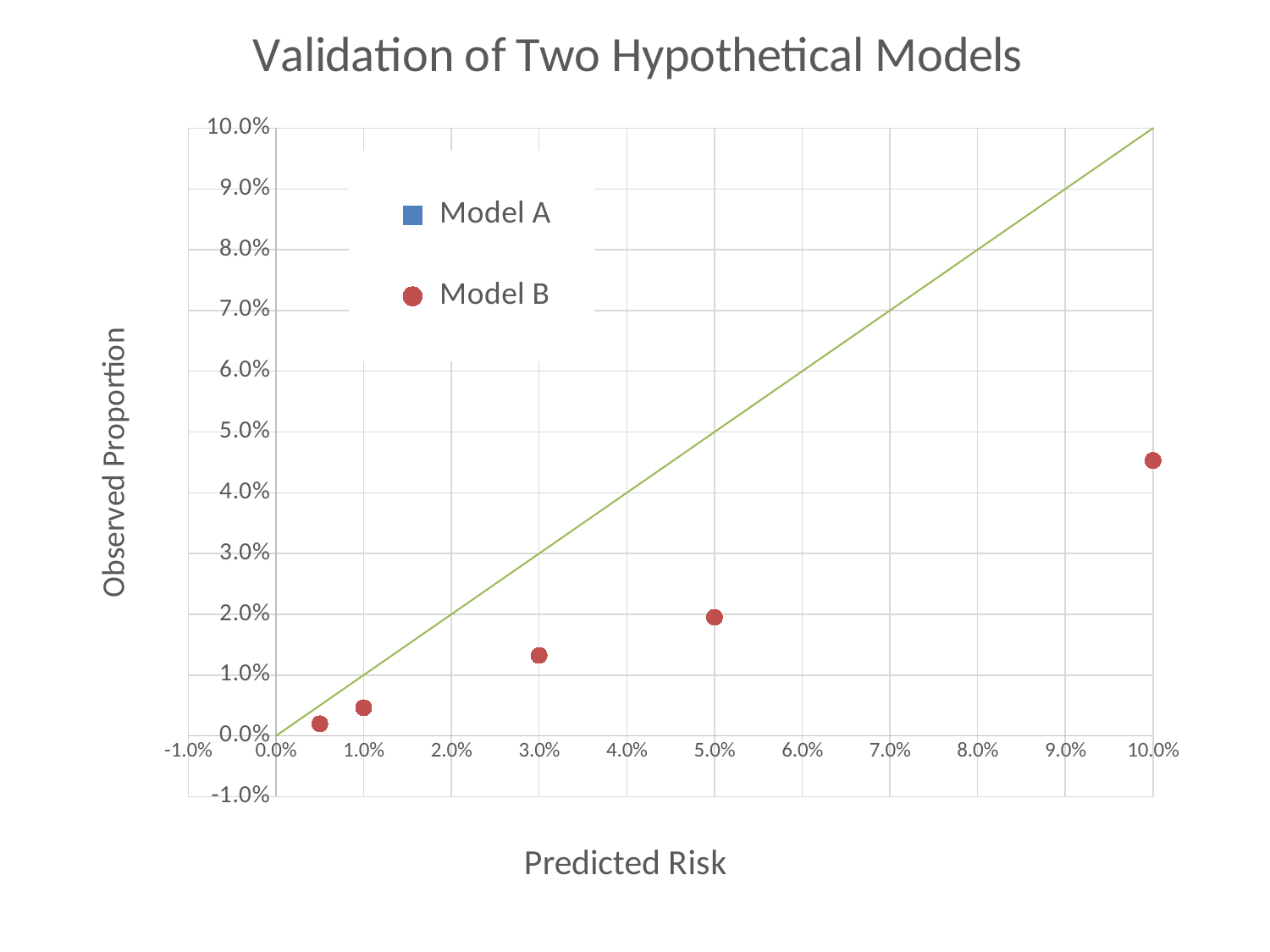
How many series does the legend list? 2 What is the label of the x axis? Predicted Risk Do the Model B observed proportions rise or fall as predicted risk increases along the x axis? rise How many Model B points are plotted on the chart? 5 What kind of chart is shown on the slide? scatter chart Is the observed proportion for Model B at a predicted risk of 10.0% greater or less than 4.0%? greater Is the observed proportion for Model B at a predicted risk of 1.0% greater or less than 1.0%? less What is the title of the chart? Validation of Two Hypothetical Models Is the observed proportion for Model B at a predicted risk of 3.0% greater or less than 1.0%? greater At which predicted risk does Model B have the highest observed proportion? 10.0%